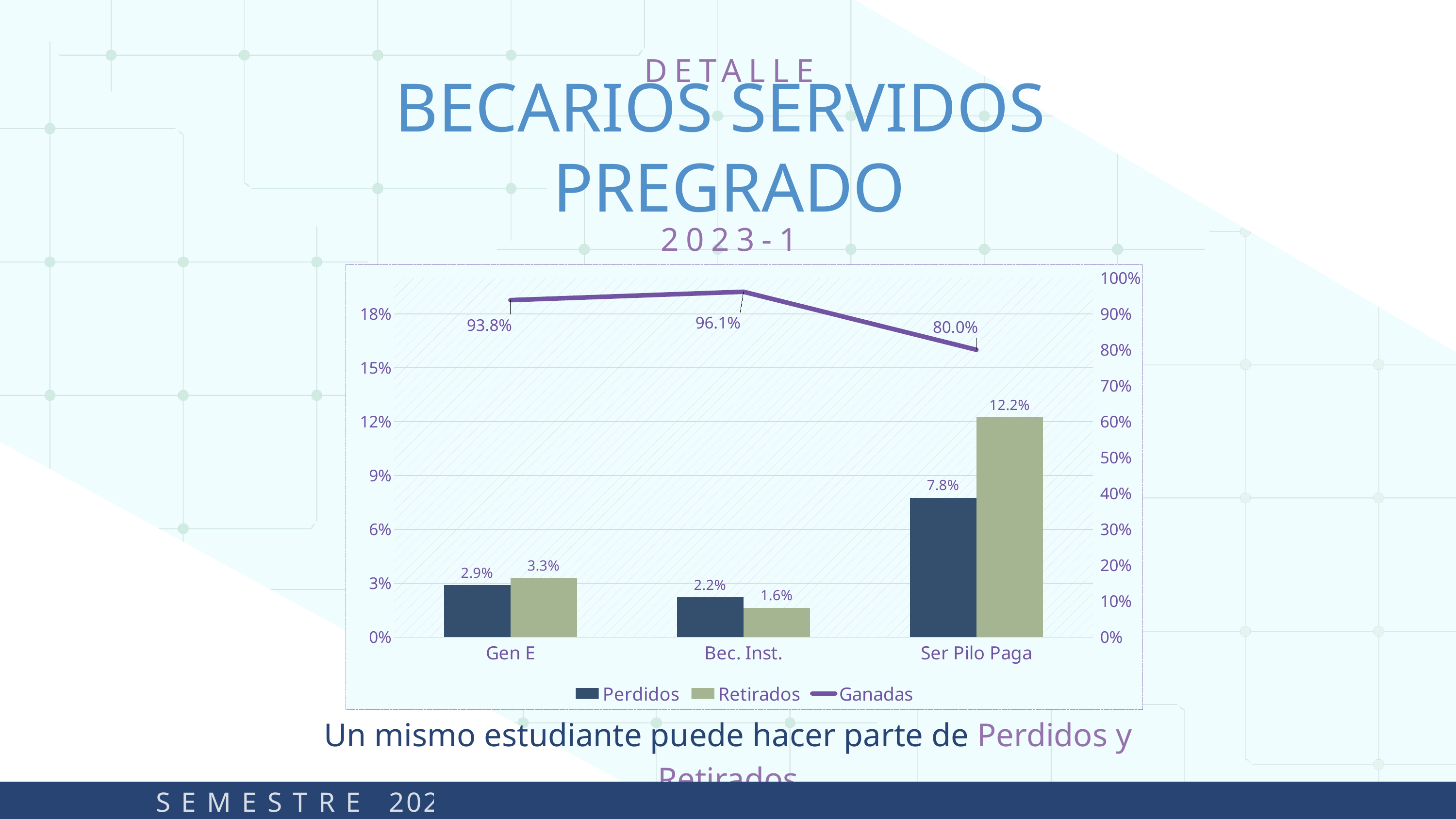
Which category has the highest Retirados value? Ser Pilo Paga How many categories are shown on the x axis? 3 Which series is drawn as a line rather than bars? Ganadas How many series does the legend list? 3 What is the Perdidos value for Ser Pilo Paga? 7.8% What is the difference between the Retirados and Perdidos values for Ser Pilo Paga? 4.4% Which category has the lowest Ganadas value? Ser Pilo Paga What is the Retirados value for Gen E? 3.3% What kind of chart is shown? Combined bar and line chart What is the Ganadas value for Bec. Inst.? 96.1% Which is larger for Bec. Inst., Perdidos or Retirados? Perdidos Does the Ganadas line rise or fall from Bec. Inst. to Ser Pilo Paga? Fall